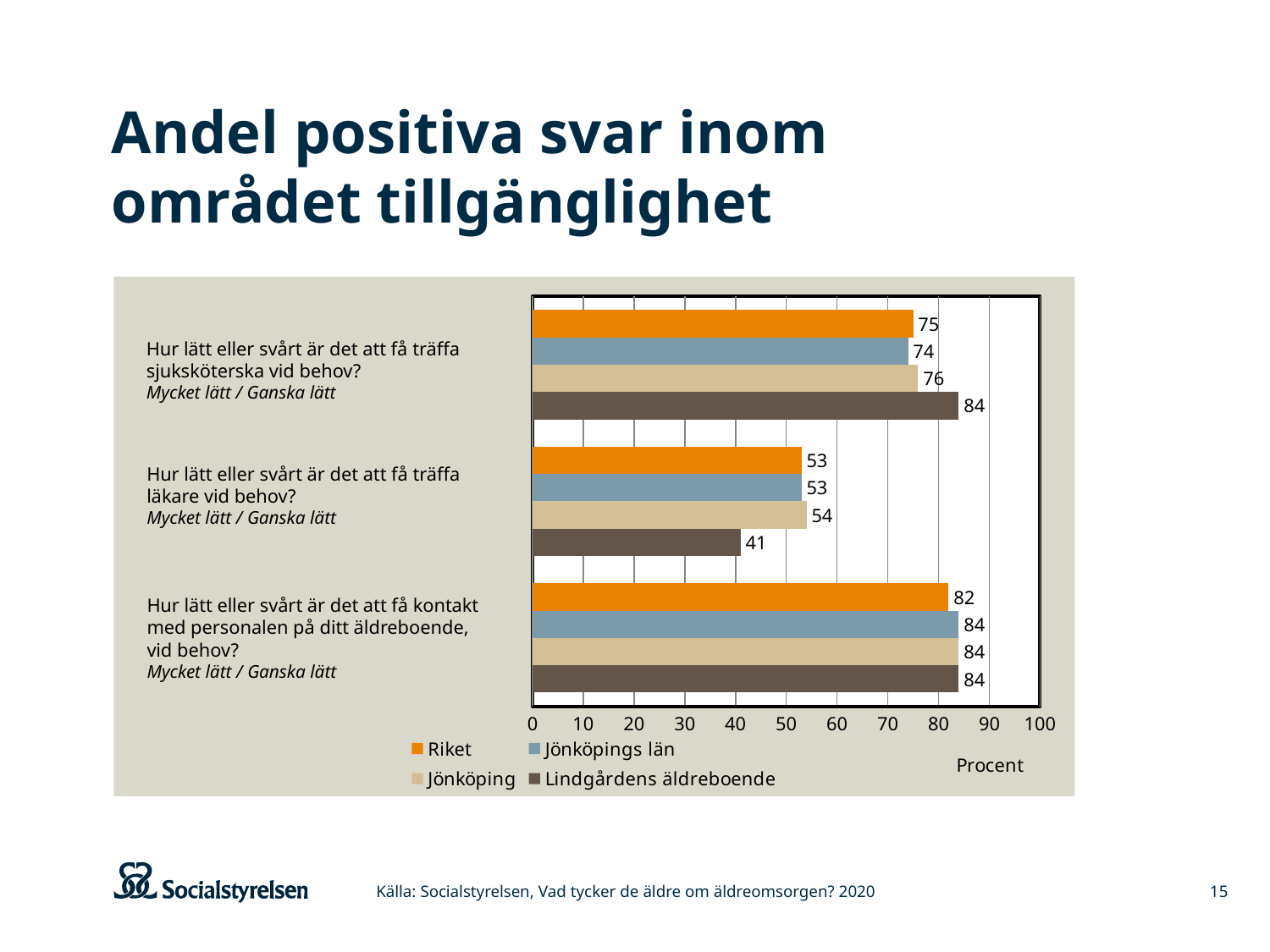
How many question categories are shown on the chart? 3 What is the difference between Riket and Lindgårdens äldreboende for the question about meeting a nurse (träffa sjuksköterska vid behov)? 9 What is the difference between Jönköping and Lindgårdens äldreboende for the question about meeting a doctor (träffa läkare vid behov)? 13 What kind of chart is shown on the slide? bar chart What is the value for Lindgårdens äldreboende for the question about meeting a nurse (träffa sjuksköterska vid behov)? 84 How many series does the legend list? 4 What is the value for Jönköping for the question about contacting staff at the care home (få kontakt med personalen)? 84 What is the value for Riket for the question about meeting a doctor (träffa läkare vid behov)? 53 Which series has the lowest value for the question about meeting a doctor (träffa läkare vid behov)? Lindgårdens äldreboende For the question about contacting staff at the care home, is the value for Riket larger or smaller than the value for Jönköpings län? smaller What is the label on the horizontal axis of the chart? Procent Which series has the highest value for the question about meeting a nurse (träffa sjuksköterska vid behov)? Lindgårdens äldreboende